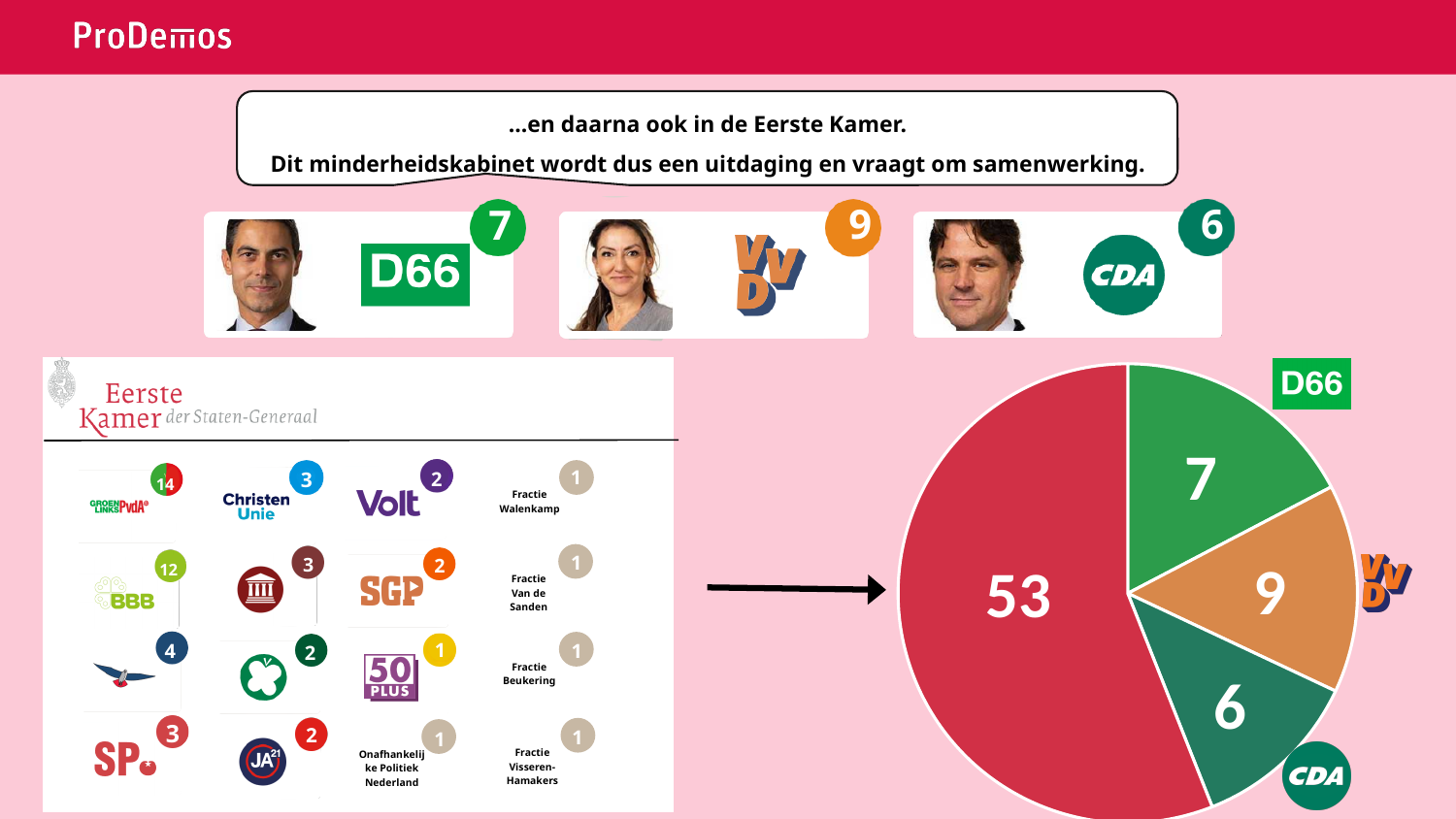
In the pie chart, how many seats does D66 have? 7 How many slices does the pie chart have? 4 Of the three labelled parties in the pie chart (D66, VVD, CDA), which has the fewest seats? CDA In the pie chart, how many seats does CDA have? 6 In the pie chart, how many more seats does VVD have than D66? 2 What is the total of all values shown in the pie chart? 75 What share of the pie chart does the VVD slice (9) represent? 12% What kind of chart is shown on the right side of the slide? pie chart In the pie chart, how many seats does VVD have? 9 Of the three labelled parties in the pie chart (D66, VVD, CDA), which has the most seats? VVD In the pie chart, which has more seats, D66 or CDA? D66 In the pie chart, what value is shown on the largest (red) slice? 53